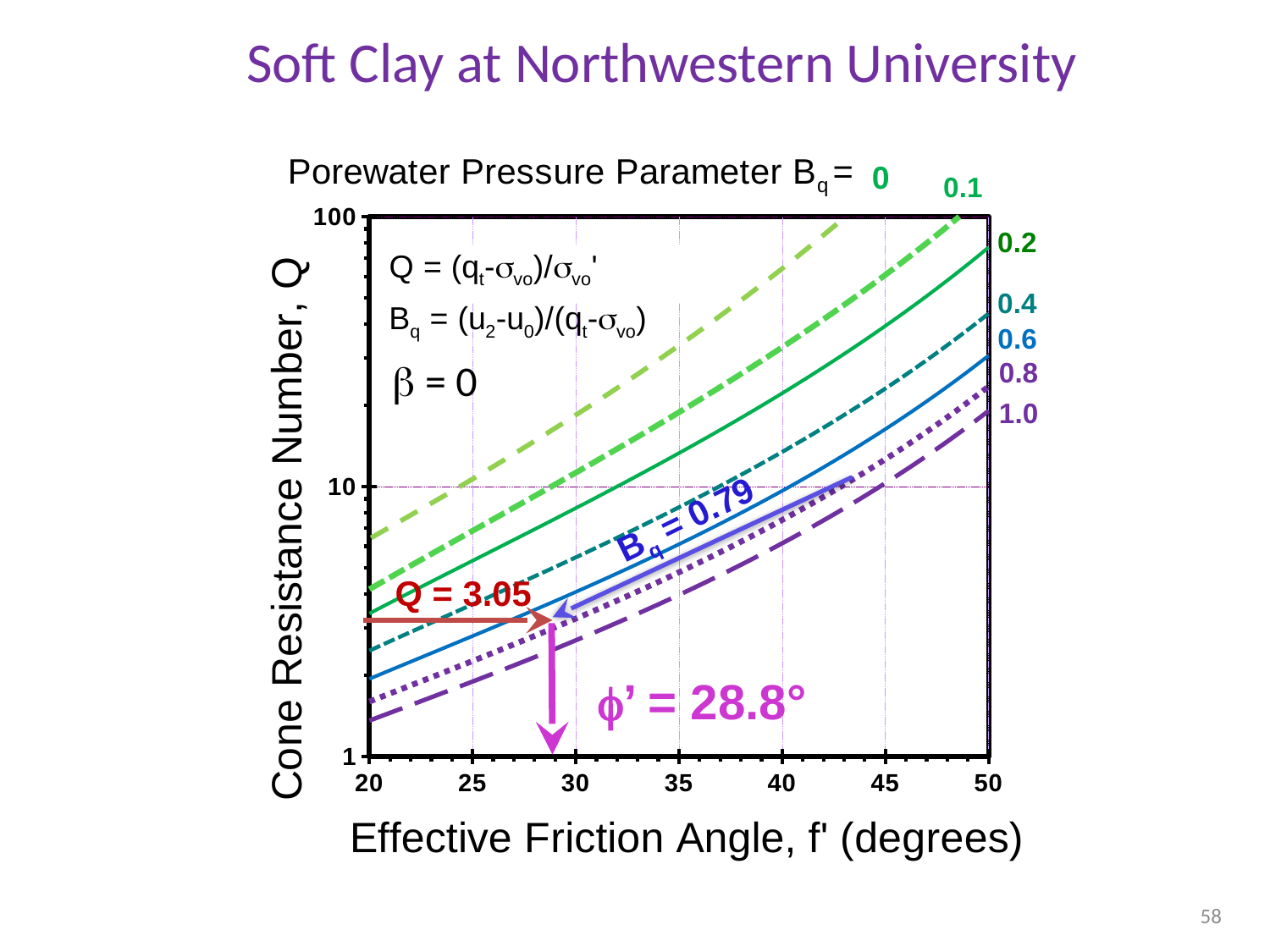
What effective friction angle is indicated by the vertical arrow annotation? 28.8° What kind of chart is shown on the slide? line chart Which Bq curve gives the highest Q at any given friction angle? Bq = 0 Is the value of Q on the Bq = 0 curve at 40 degrees greater or less than 10? greater How many Bq curves are plotted on the chart? 7 What Bq value is written along the highlighted curve segment? 0.79 At a friction angle of 35 degrees, which curve has the larger Q: Bq = 0 or Bq = 1.0? Bq = 0 What is the label of the x axis of the chart? Effective Friction Angle, f' (degrees) What value of Q is marked by the horizontal arrow annotation on the chart? Q = 3.05 Is the value of Q on the Bq = 1.0 curve at 20 degrees greater or less than 10? less Which Bq curve gives the lowest Q at any given friction angle? Bq = 1.0 Does the cone resistance number Q rise or fall as the effective friction angle increases? rise